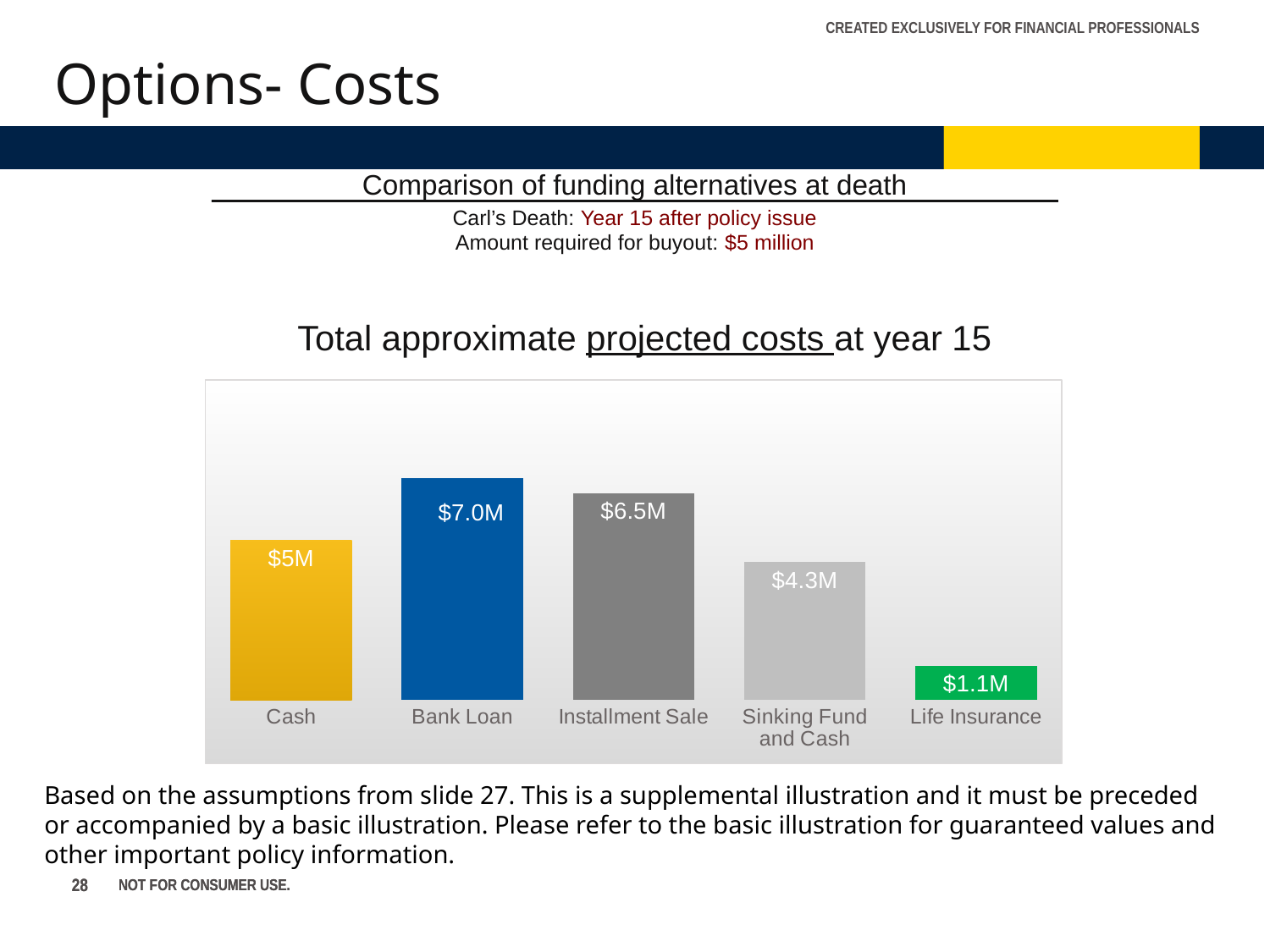
What is the title of the chart? Total approximate projected costs at year 15 What is the difference between the projected costs of the Installment Sale and Life Insurance options? $5.4M How many funding options are shown in the chart? 5 What is the projected cost at year 15 for the Installment Sale option? $6.5M What is the difference between the projected costs of the Bank Loan and Cash options? $2.0M Which funding option has the lowest projected cost at year 15? Life Insurance What type of chart is used to show the projected costs? Bar chart What is the projected cost at year 15 for the Life Insurance option? $1.1M What is the projected cost at year 15 for the Sinking Fund and Cash option? $4.3M What is the projected cost at year 15 for the Bank Loan option? $7.0M Which funding option has the highest projected cost at year 15? Bank Loan Which has a higher projected cost, Cash or Sinking Fund and Cash? Cash